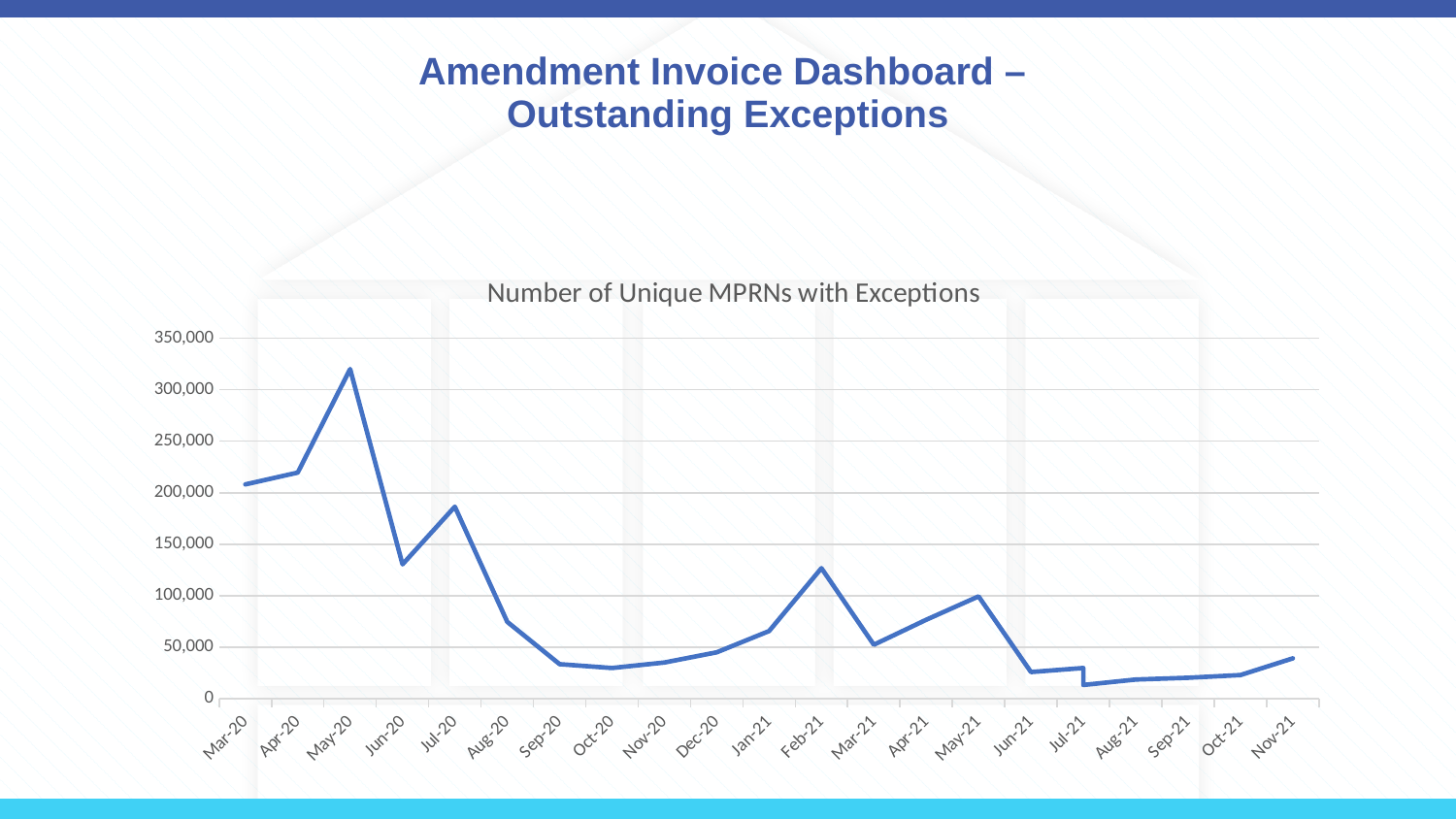
Which month has the highest number of unique MPRNs with exceptions? May-20 Is the value for Mar-20 greater or less than 200,000? greater How many months are plotted along the x axis? 21 Is the value for Sep-20 greater or less than 50,000? less What kind of chart is shown on the slide? line chart Is the value for Feb-21 greater or less than 100,000? greater Which is larger, the value for May-20 or the value for Jul-20? May-20 Which is larger, the value for Feb-21 or the value for Mar-21? Feb-21 Do the values rise or fall from May-20 to Sep-20? fall What is the title of the chart? Number of Unique MPRNs with Exceptions